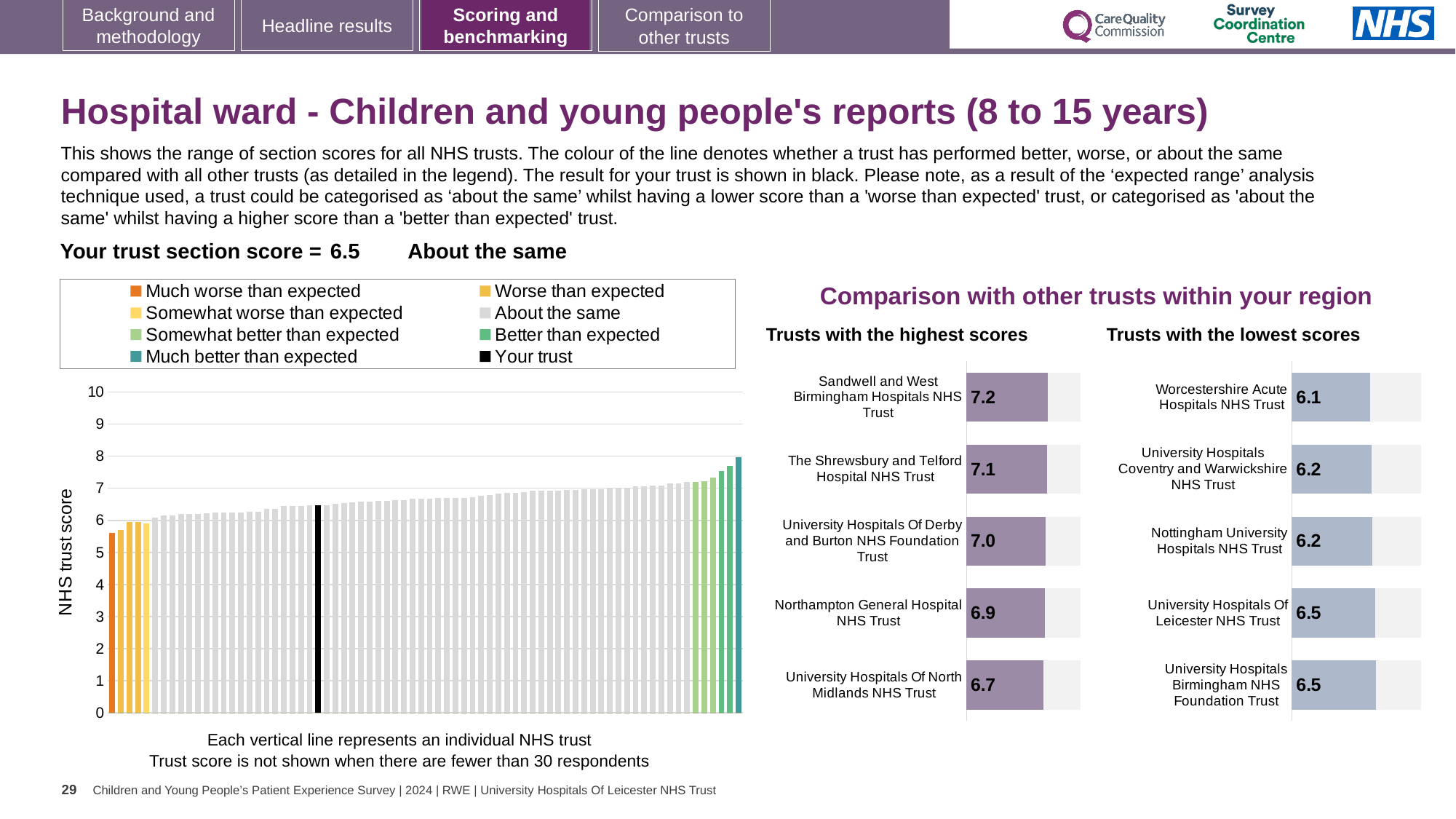
In the 'Trusts with the highest scores' chart, which has the larger score: The Shrewsbury and Telford Hospital NHS Trust or University Hospitals Of Derby and Burton NHS Foundation Trust? The Shrewsbury and Telford Hospital NHS Trust In the 'Trusts with the highest scores' chart, what is the difference between the scores of Sandwell and West Birmingham Hospitals NHS Trust and Northampton General Hospital NHS Trust? 0.3 In the 'Trusts with the lowest scores' chart, what is the score for University Hospitals Of Leicester NHS Trust? 6.5 In the 'Trusts with the highest scores' chart, what is the score for University Hospitals Of North Midlands NHS Trust? 6.7 How many entries does the legend of the NHS trust score chart on the left list? 8 In the NHS trust score chart on the left, do the bar values rise or fall from left to right? rise In the 'Trusts with the highest scores' chart, what is the score for Sandwell and West Birmingham Hospitals NHS Trust? 7.2 In the NHS trust score chart on the left, is the value of the tallest bar greater or less than 7? greater In the 'Trusts with the lowest scores' chart, which trust has the lowest score? Worcestershire Acute Hospitals NHS Trust How many trusts are shown in the 'Trusts with the lowest scores' chart? 5 In the 'Trusts with the highest scores' chart, which trust has the highest score? Sandwell and West Birmingham Hospitals NHS Trust In the 'Trusts with the lowest scores' chart, what is the score for Worcestershire Acute Hospitals NHS Trust? 6.1